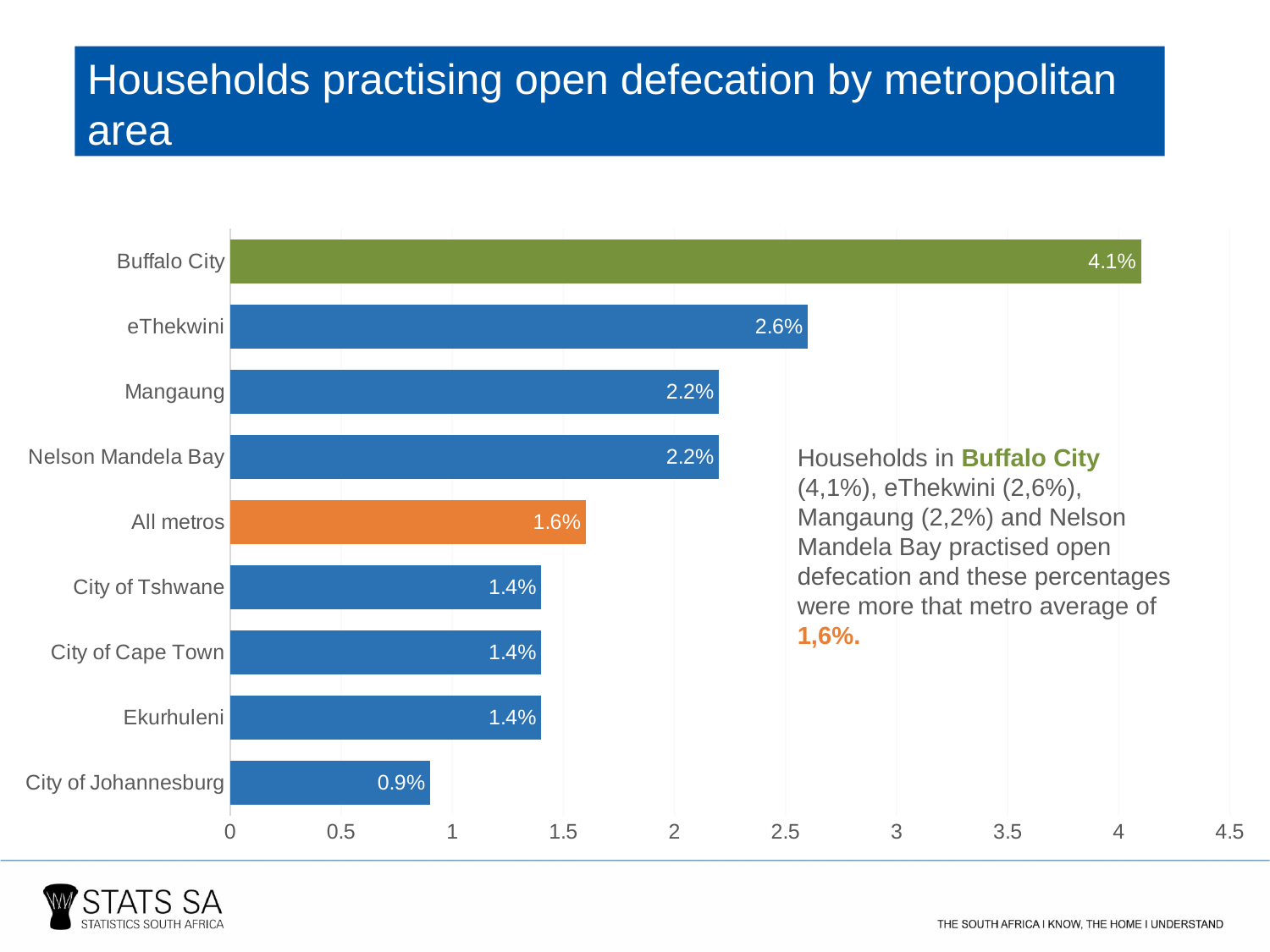
How many categories are shown on the chart? 9 Which bar is coloured orange? All metros What is the difference between the values for Buffalo City and eThekwini? 1.5% What is the value for City of Johannesburg? 0.9% What is the value for Buffalo City? 4.1% Which metropolitan area has the lowest value? City of Johannesburg What kind of chart is shown on the slide? Bar chart Which metropolitan area has the highest value? Buffalo City What is the value for eThekwini? 2.6% Which is larger, the value for Mangaung or the value for City of Tshwane? Mangaung What is the value for All metros? 1.6% Is the value for eThekwini greater or less than 2.5? greater